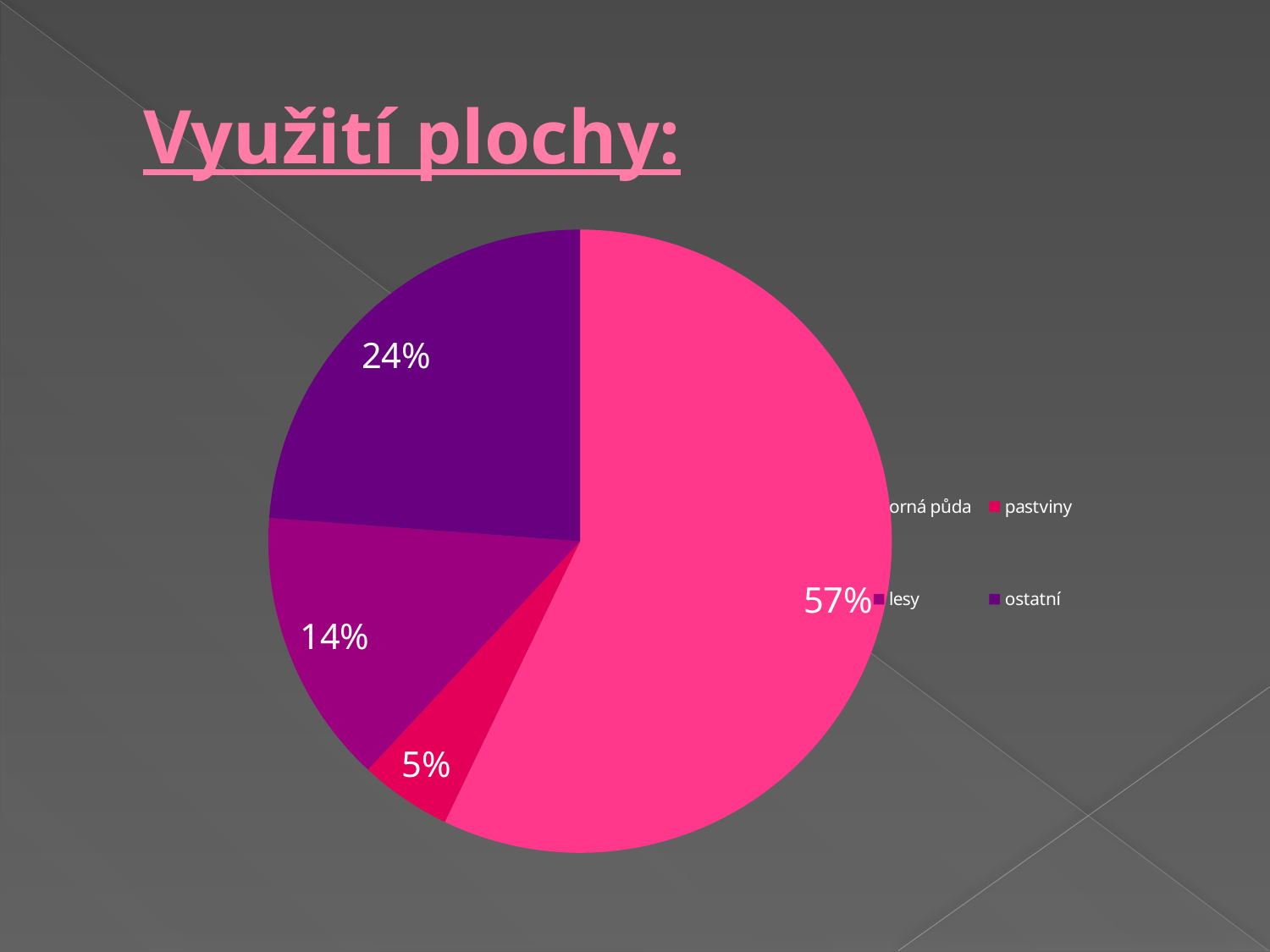
What share of the pie is orná půda? 57% What is the difference in percentage points between orná půda and ostatní? 33 What share of the pie is lesy? 14% What share of the pie is ostatní? 24% What is the title of the chart on the slide? Využití plochy: Which category has the smallest share of the pie? pastviny Which is larger, the share for lesy or the share for ostatní? ostatní How many entries does the legend list? 4 How many slices does the pie chart have? 4 Which category has the largest share of the pie? orná půda What kind of chart is shown on the slide? pie chart